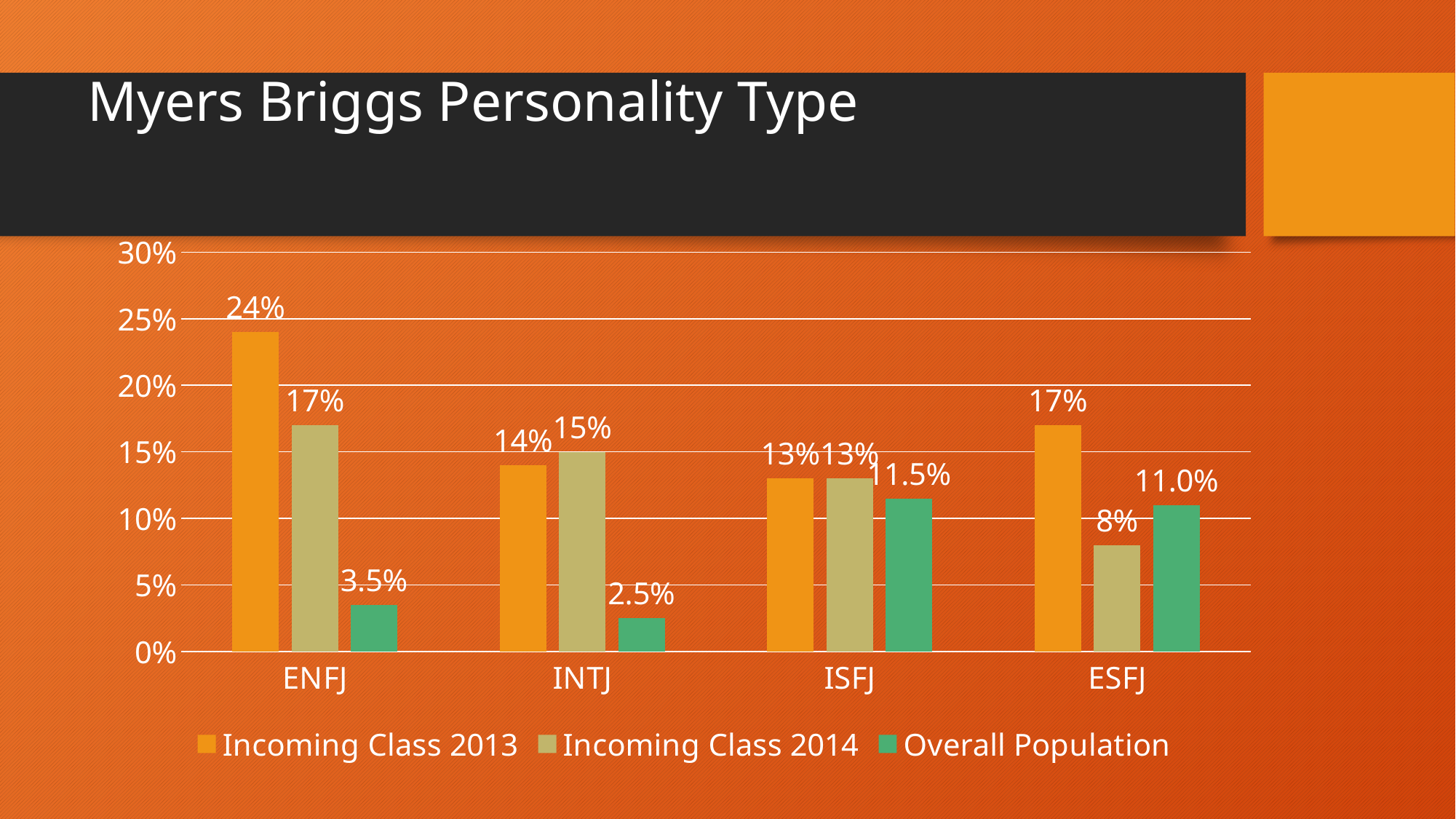
What is the difference between the Incoming Class 2013 and Incoming Class 2014 values for ENFJ? 7% Which personality type has the lowest value for Overall Population? INTJ What is the value for Incoming Class 2013 in the ENFJ category? 24% What is the title of the slide? Myers Briggs Personality Type Which is larger for ESFJ: Incoming Class 2013 or Overall Population? Incoming Class 2013 How many series does the legend list? 3 How many personality type categories are shown on the x axis? 4 Which personality type has the highest value for Incoming Class 2013? ENFJ What is the Overall Population value for ISFJ? 11.5% What is the value for Incoming Class 2014 in the ESFJ category? 8% What is the Overall Population value for INTJ? 2.5% What kind of chart is shown on the slide? Bar chart